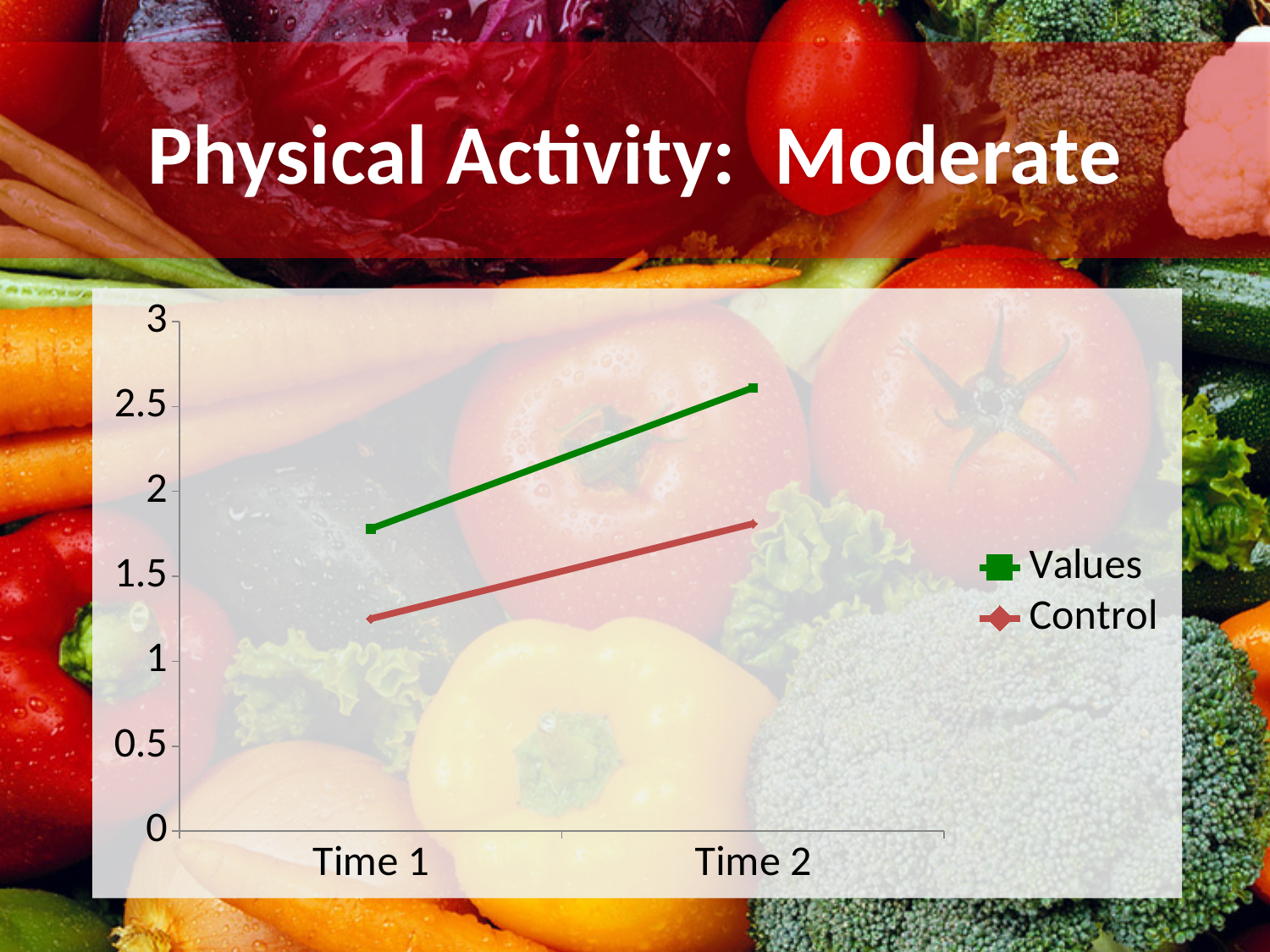
Does the Control series rise or fall from Time 1 to Time 2? rise How many series does the legend list? 2 At Time 1, which series has the lower value, Values or Control? Control Is the value for the Control series at Time 2 greater or less than 2? less What are the two series named in the legend? Values and Control Is the value for the Values series at Time 1 greater or less than 1.5? greater At Time 2, which series has the higher value, Values or Control? Values Is the value for the Control series at Time 1 greater or less than 1.5? less Does the Values series rise or fall from Time 1 to Time 2? rise How many time points are shown on the x axis? 2 What kind of chart is shown on the slide? line chart